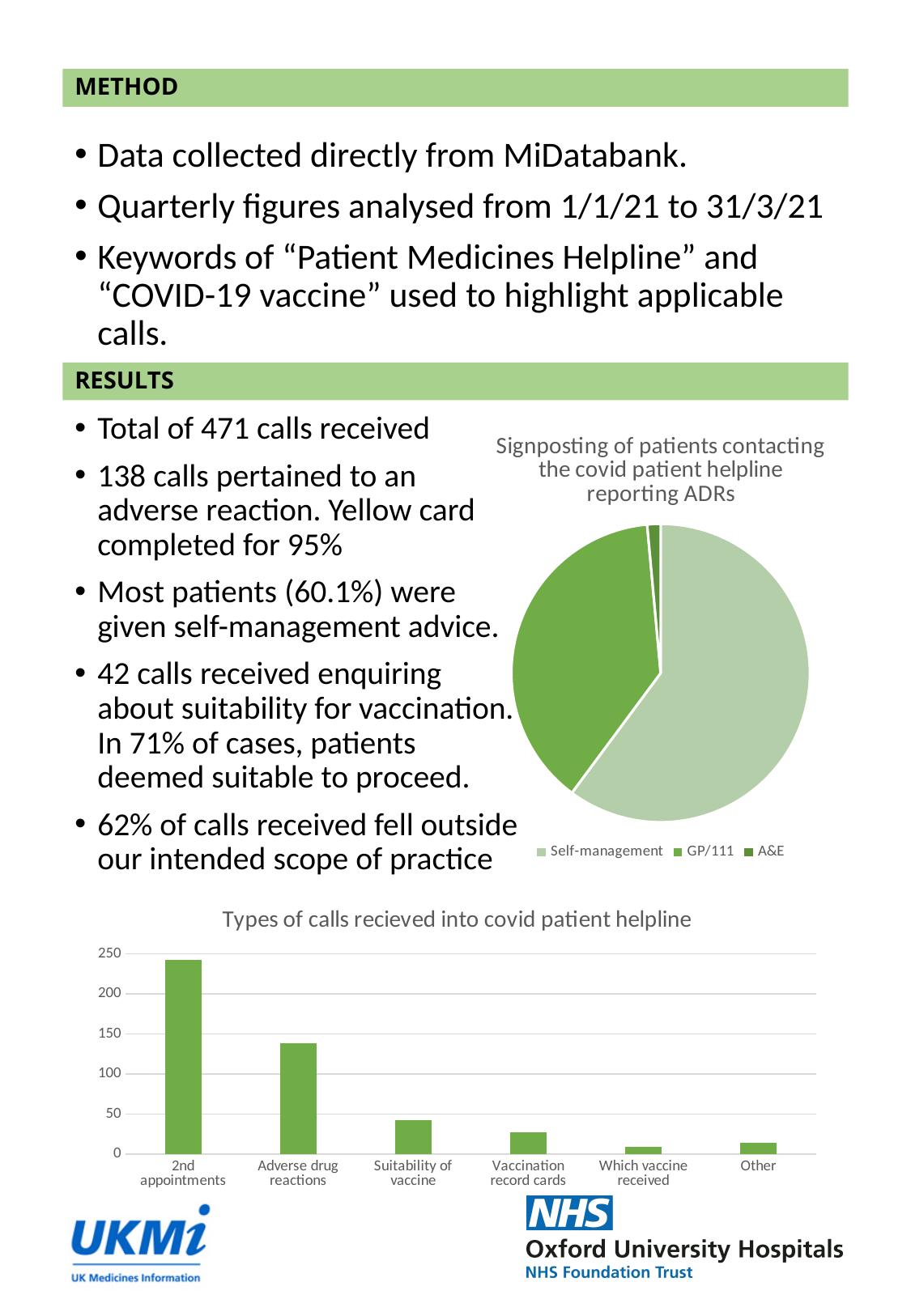
In the bar chart "Types of calls recieved into covid patient helpline", which category has the highest bar? 2nd appointments In the pie chart "Signposting of patients contacting the covid patient helpline reporting ADRs", how many entries does the legend list? 3 In the bar chart "Types of calls recieved into covid patient helpline", is the value for Adverse drug reactions greater or less than 100? greater In the bar chart "Types of calls recieved into covid patient helpline", which is larger: Adverse drug reactions or Vaccination record cards? Adverse drug reactions In the bar chart "Types of calls recieved into covid patient helpline", is the value for 2nd appointments greater or less than 200? greater What kind of chart is the chart titled "Types of calls recieved into covid patient helpline"? bar chart What kind of chart is the chart titled "Signposting of patients contacting the covid patient helpline reporting ADRs"? pie chart In the bar chart "Types of calls recieved into covid patient helpline", which category has the lowest bar? Which vaccine received In the pie chart "Signposting of patients contacting the covid patient helpline reporting ADRs", which category has the largest slice? Self-management In the bar chart "Types of calls recieved into covid patient helpline", how many categories are shown on the x axis? 6 In the pie chart "Signposting of patients contacting the covid patient helpline reporting ADRs", which category has the smallest slice? A&E In the bar chart "Types of calls recieved into covid patient helpline", is the value for Suitability of vaccine greater or less than 50? less